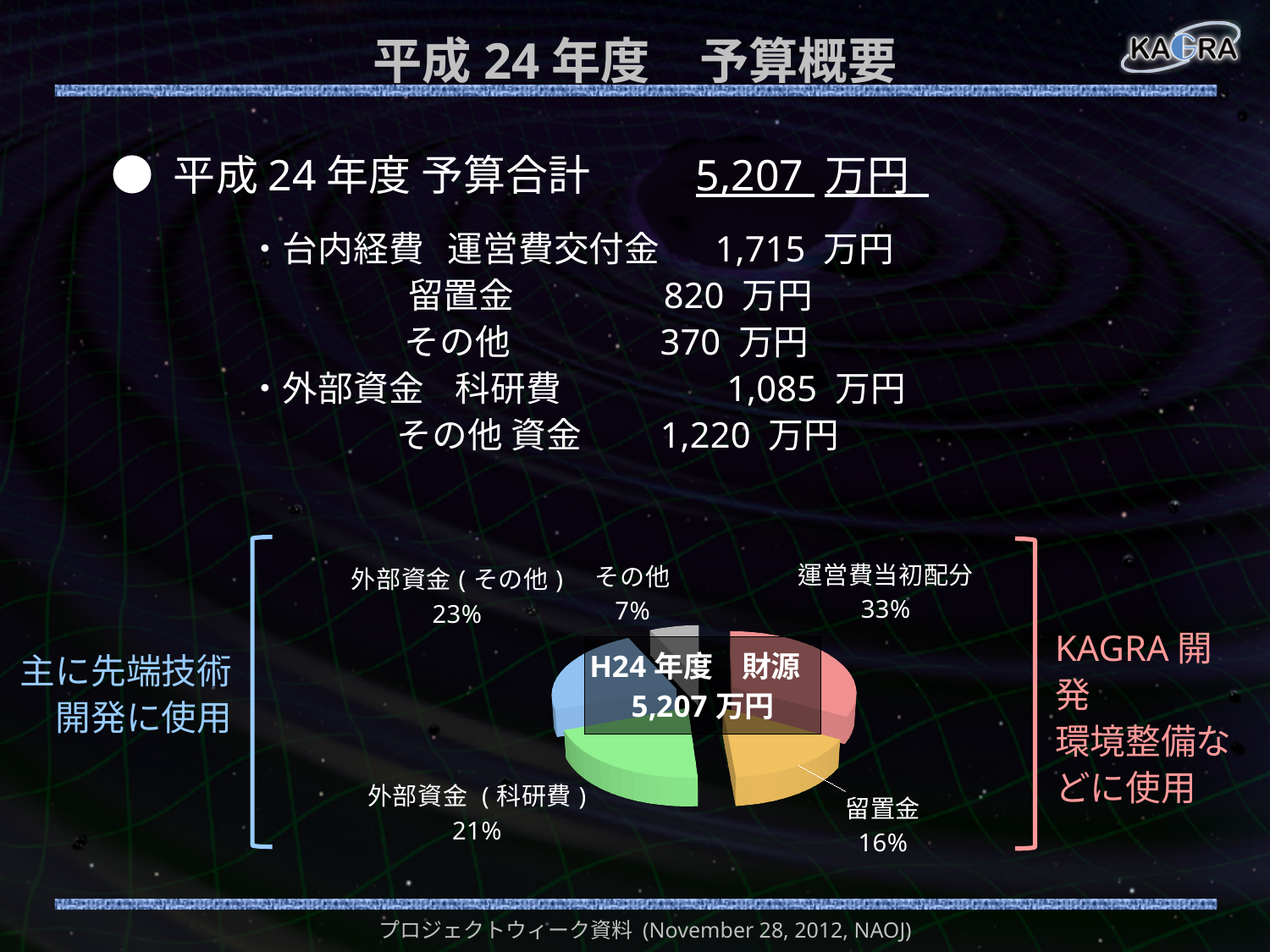
What share of the pie chart does 外部資金（その他） represent? 23% Which slice of the pie chart is the smallest? その他 Which slice of the pie chart is the largest? 運営費当初配分 What share of the pie chart does 留置金 represent? 16% What total amount is shown in the centre of the pie chart? 5,207万円 What type of chart is shown on the slide? Pie chart How many slices does the pie chart have? 5 What share of the pie chart does 運営費当初配分 represent? 33% Which is larger in the pie chart, 外部資金（その他） or 外部資金（科研費）? 外部資金（その他） What is the difference in percentage points between 運営費当初配分 and 留置金 in the pie chart? 17